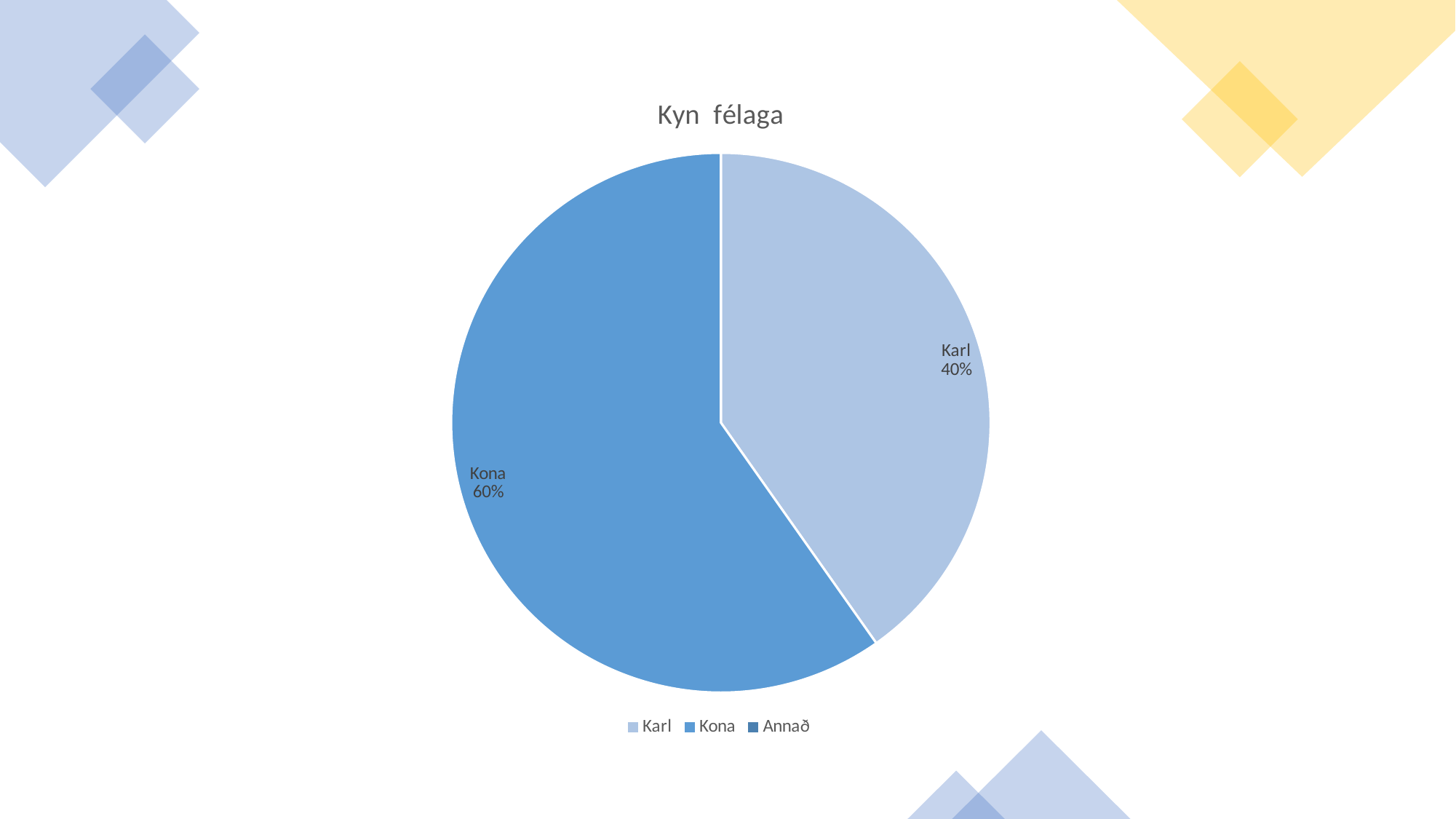
Which legend entry has no visible slice in the pie? Annað What percentage of the pie is the Karl slice? 40% What percentage of the pie is the Kona slice? 60% Which is larger, the Karl slice or the Kona slice? Kona What is the title of the chart? Kyn félaga What kind of chart is shown on the slide? pie chart Which of the two visible slices is the smallest? Karl How many entries does the legend list? 3 What share of the pie does the Kona slice represent? 60% How many slices are visible in the pie chart? 2 What is the difference in percentage points between the Kona slice and the Karl slice? 20 Which slice is the largest in the pie chart? Kona